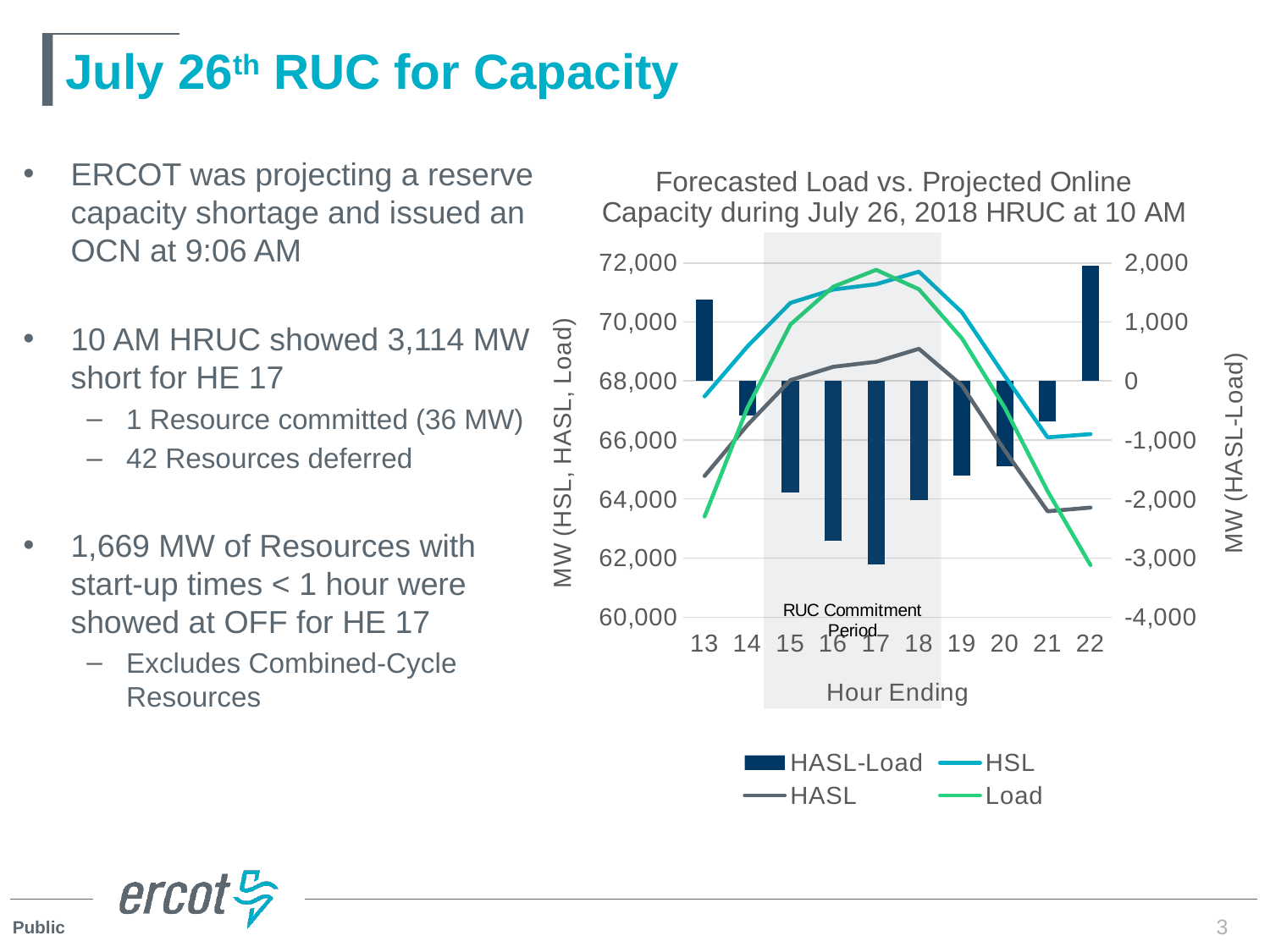
At which hour ending does the Load line reach its peak? 17 What kind of chart is shown on the slide? A combination bar and line chart Which is larger at hour ending 17, the Load value or the HASL value? Load What label is shown on the shaded region of the chart? RUC Commitment Period Is the HASL-Load value for hour ending 17 greater or less than -2,000? less At which hour ending is the HASL-Load bar lowest? 17 Does the Load line rise or fall from hour ending 13 to hour ending 17? rise At which hour ending is the HASL-Load bar highest? 22 How many hour-ending categories are shown on the x axis? 10 Is the Load value for hour ending 17 greater or less than 70,000? greater Is the HASL-Load value for hour ending 22 greater or less than 1,000? greater How many series does the chart legend list? 4